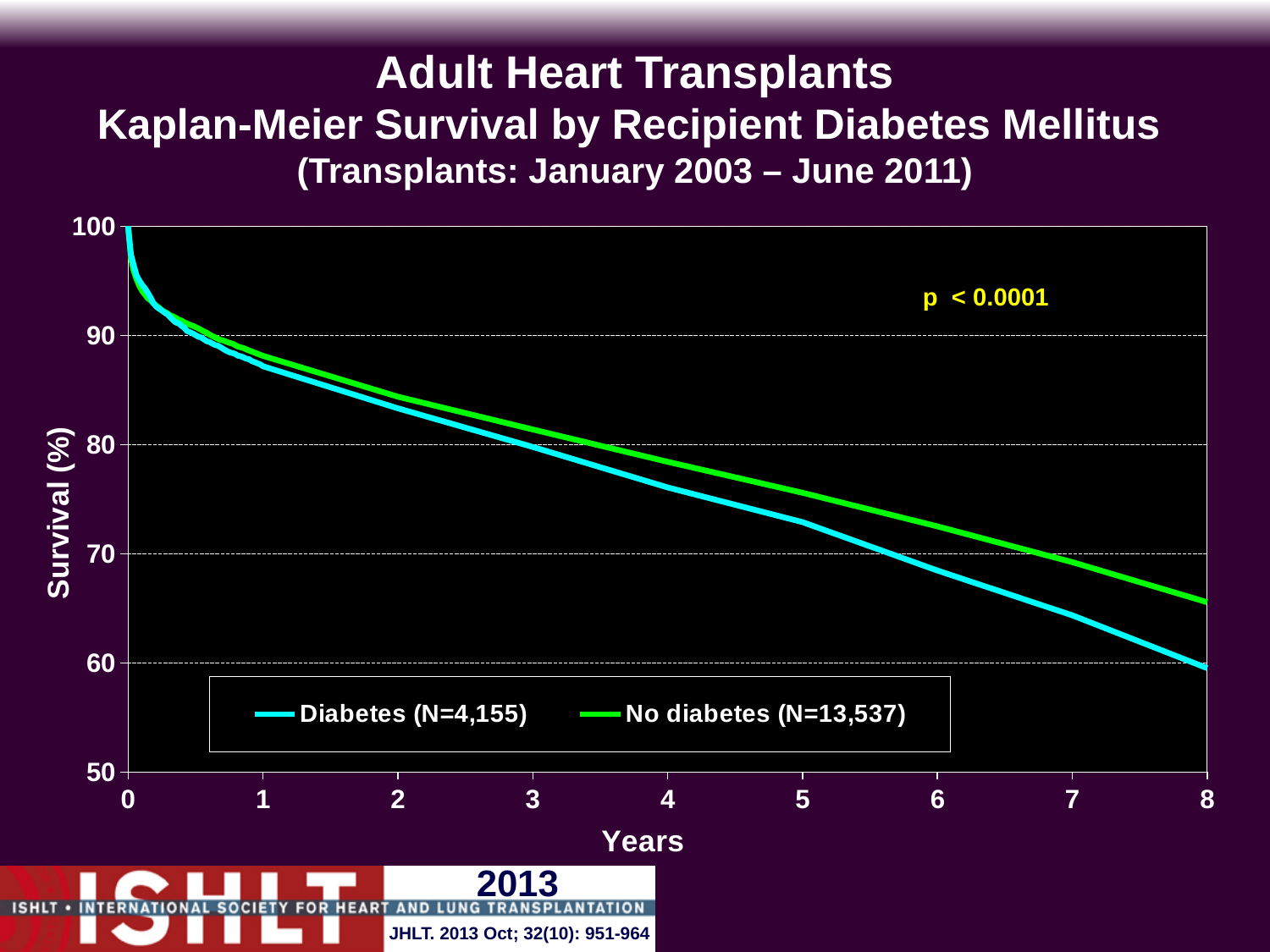
Do the survival curves rise or fall as years increase? Fall What p-value is printed on the chart? p < 0.0001 Is the survival value for the Diabetes series at 7 years greater or less than 70? less What kind of chart is shown on the slide? Line chart How many series does the legend list? 2 Is the survival value for the Diabetes series at 5 years greater or less than 70? greater Which series has the higher survival at 8 years, Diabetes or No diabetes? No diabetes Is the survival value for the No diabetes series at 8 years greater or less than 70? less What is the N for the Diabetes series shown in the legend? N=4,155